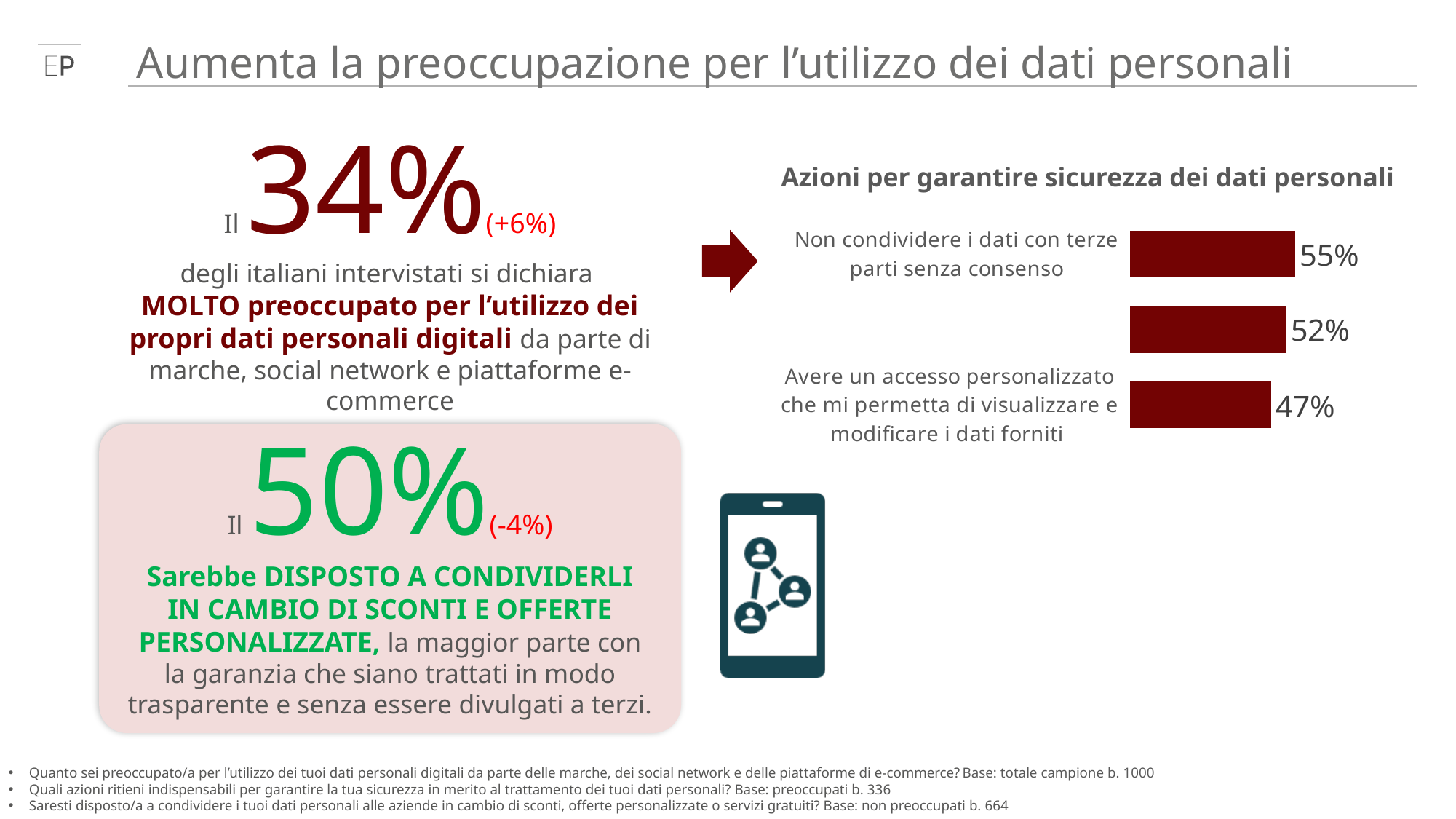
Do the bar values in the chart 'Azioni per garantire sicurezza dei dati personali' increase or decrease from top to bottom? Decrease What is the difference between the value for 'Non condividere i dati con terze parti senza consenso' and the value for 'Avere un accesso personalizzato che mi permetta di visualizzare e modificare i dati forniti'? 8% Which action has the highest value in the chart 'Azioni per garantire sicurezza dei dati personali'? Non condividere i dati con terze parti senza consenso What is the value for 'Avere un accesso personalizzato che mi permetta di visualizzare e modificare i dati forniti' in the chart? 47% What is the value shown on the middle bar of the chart 'Azioni per garantire sicurezza dei dati personali'? 52% Which action has the lowest value in the chart 'Azioni per garantire sicurezza dei dati personali'? Avere un accesso personalizzato che mi permetta di visualizzare e modificare i dati forniti How many bars are shown in the chart 'Azioni per garantire sicurezza dei dati personali'? 3 What kind of chart is 'Azioni per garantire sicurezza dei dati personali'? Bar chart What colour are the bars in the chart 'Azioni per garantire sicurezza dei dati personali'? Dark red What is the value for 'Non condividere i dati con terze parti senza consenso' in the chart 'Azioni per garantire sicurezza dei dati personali'? 55% What is the title of the chart on the right side of the slide? Azioni per garantire sicurezza dei dati personali Which is larger: the value for 'Non condividere i dati con terze parti senza consenso' or the value for 'Avere un accesso personalizzato che mi permetta di visualizzare e modificare i dati forniti'? Non condividere i dati con terze parti senza consenso